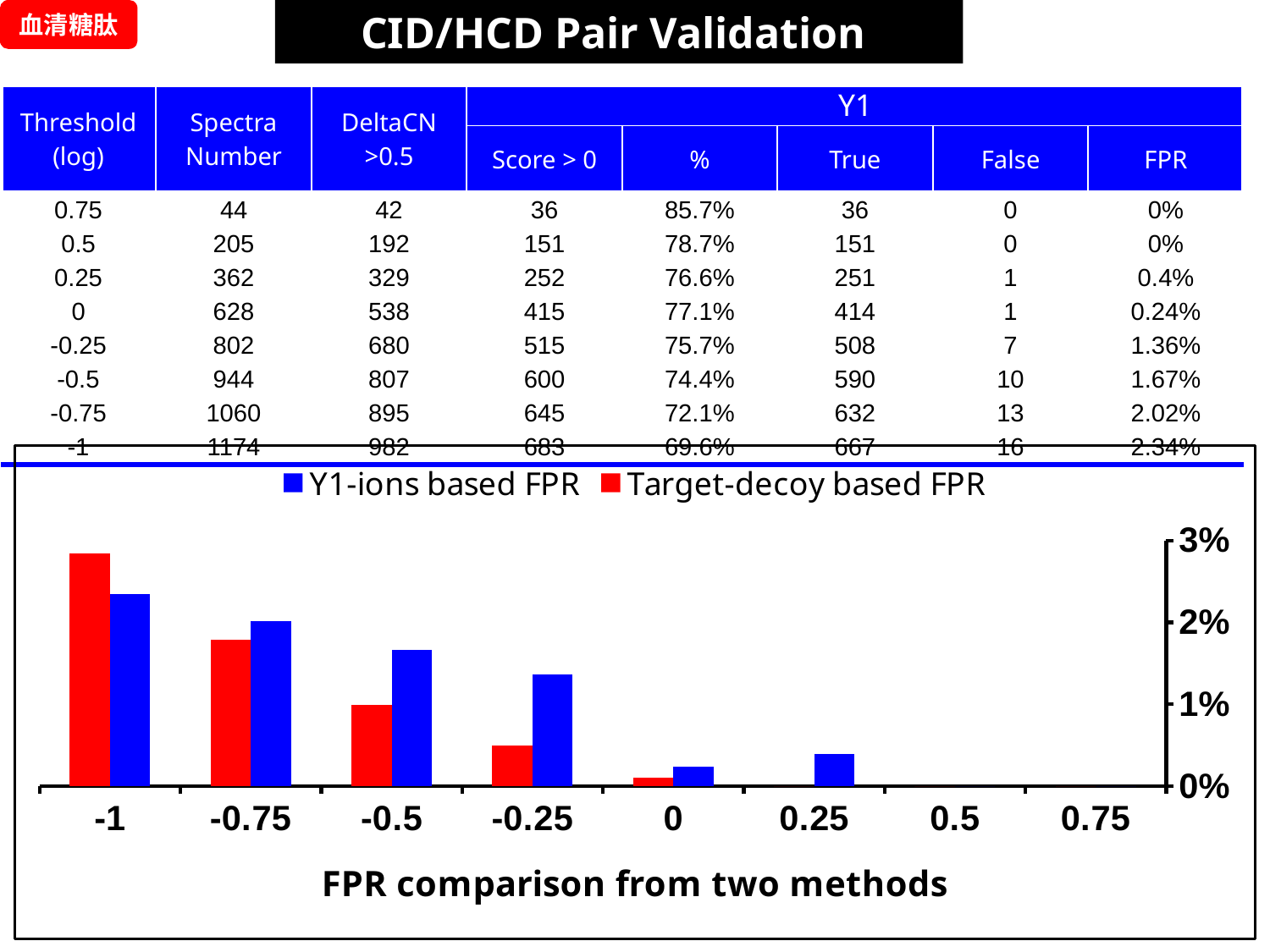
At threshold -1, which series has the larger FPR, Y1-ions based or Target-decoy based? Target-decoy based FPR Is the Y1-ions based FPR value at threshold -1 greater or less than 2%? greater Do the Y1-ions based FPR values rise or fall as the threshold increases from -1 to 0.75? fall Is the Target-decoy based FPR value at threshold -0.25 greater or less than 1%? less Is the Target-decoy based FPR value at threshold -0.75 greater or less than 2%? less What is the title of the chart? FPR comparison from two methods How many threshold categories are shown on the x axis of the chart? 8 Which colour represents the Target-decoy based FPR series in the chart? red At threshold -0.5, which series has the larger FPR, Y1-ions based or Target-decoy based? Y1-ions based FPR What kind of chart is shown on the slide? bar chart How many series does the chart legend list? 2